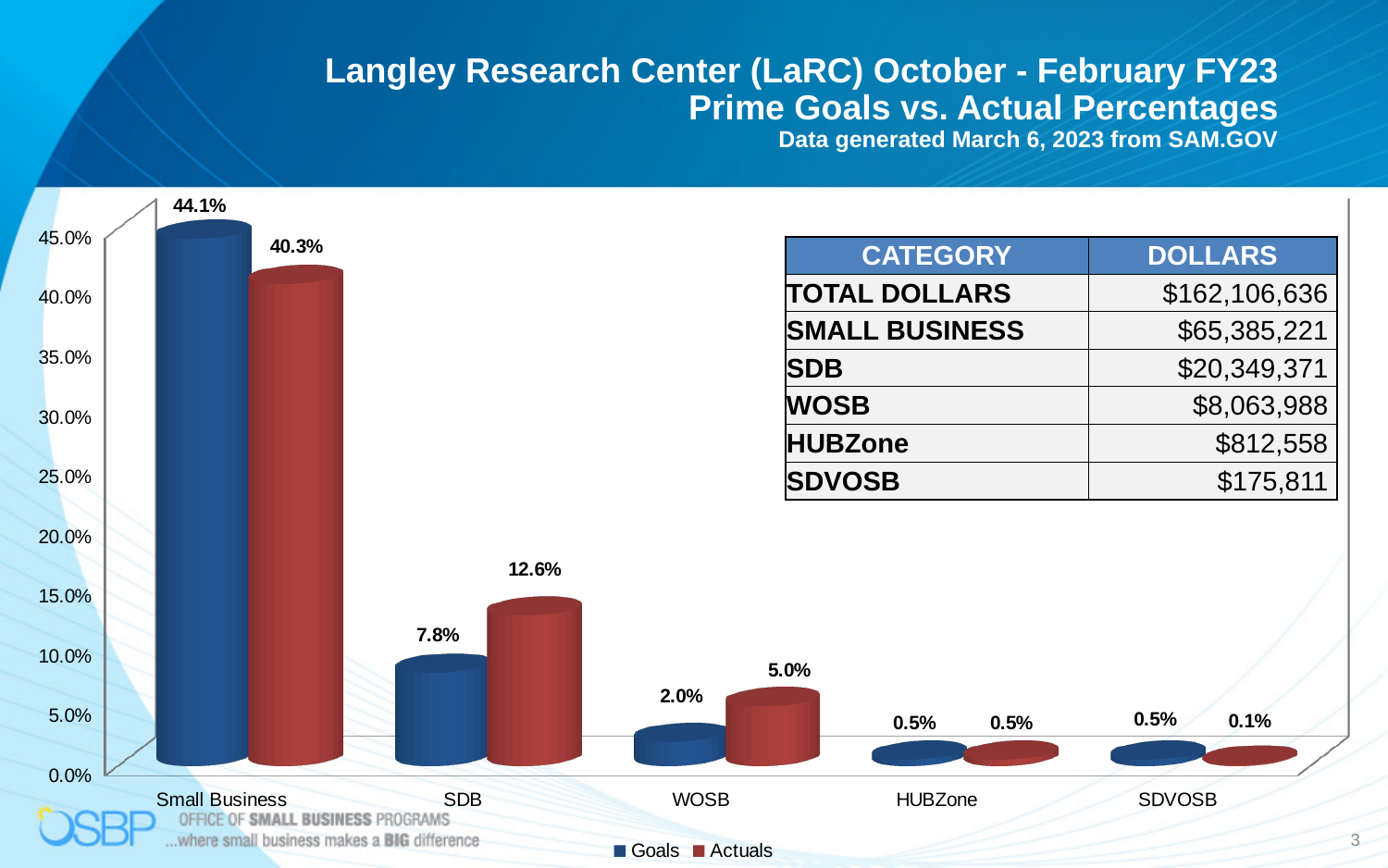
How many categories are shown on the x axis? 5 What is the Actuals value for WOSB? 5.0% Which category has the lowest Actuals value? SDVOSB Which colour represents the Actuals series? Red What kind of chart is shown on the slide? Bar chart Which is larger for SDB, the Goals value or the Actuals value? Actuals What is the Actuals value for SDB? 12.6% What is the Goals value for SDVOSB? 0.5% What is the difference between the Goals and Actuals values for Small Business? 3.8% What is the Goals value for Small Business? 44.1% How many series does the legend list? 2 Which category has the highest Actuals value? Small Business